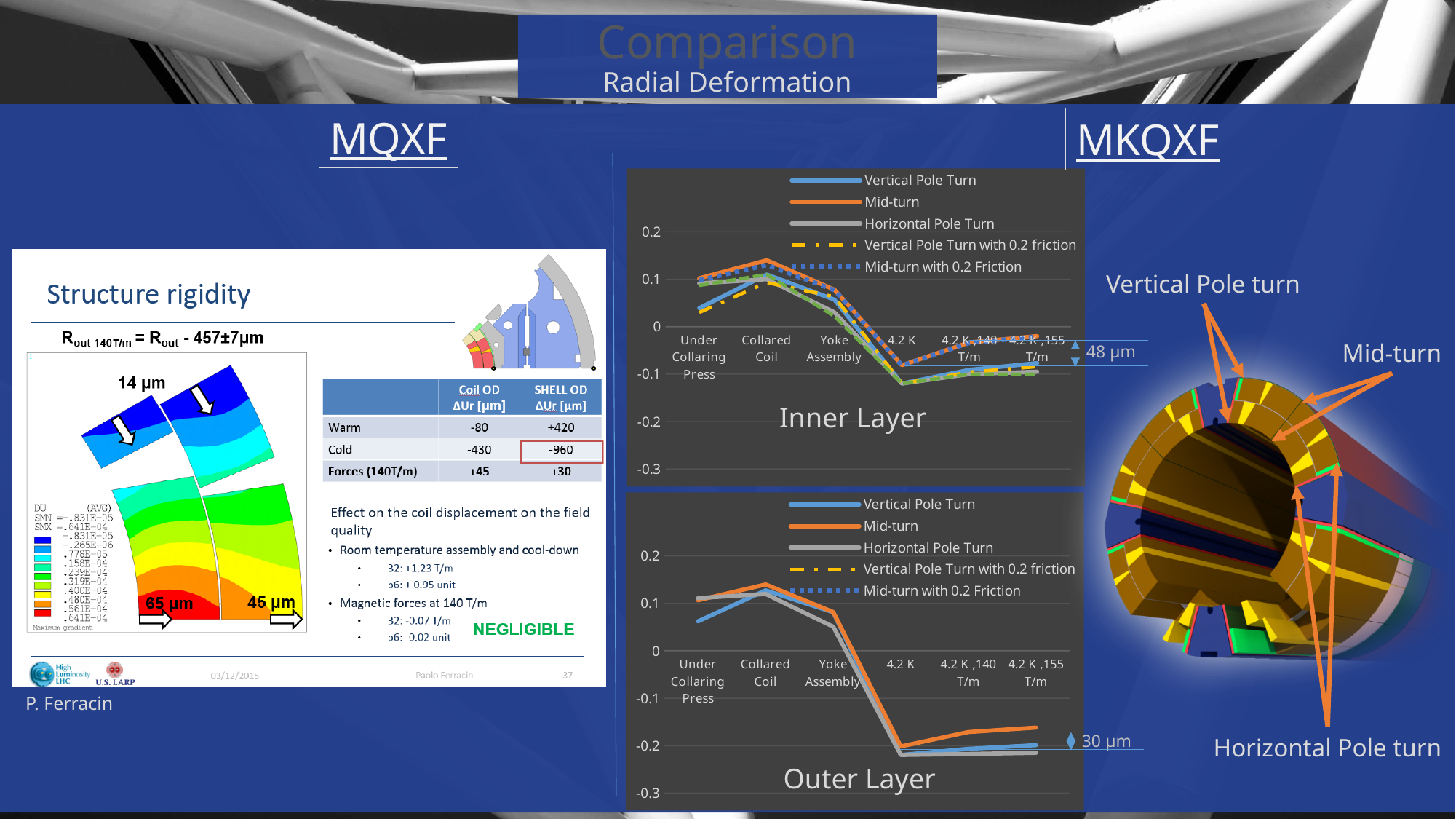
In the Outer Layer chart, is the Horizontal Pole Turn value at 4.2 K greater or less than -0.2? less How many categories are shown on the x axis of the Inner Layer chart? 6 What difference annotation is shown next to the right end of the Inner Layer chart? 48 µm What type of chart is the Inner Layer chart? line chart In the Outer Layer chart, at Under Collaring Press, which is larger: Vertical Pole Turn or Mid-turn? Mid-turn In the Outer Layer chart, is the Mid-turn value at 4.2 K ,155 T/m greater or less than -0.2? greater In the Inner Layer chart, is the Mid-turn value at Collared Coil greater or less than 0.1? greater In the Outer Layer chart, do the Mid-turn values rise or fall from Yoke Assembly to 4.2 K? fall In the Outer Layer chart, at which category does the Mid-turn series reach its lowest value? 4.2 K How many series does the legend of the Outer Layer chart list? 5 In the Inner Layer chart, at which category does the Mid-turn series reach its highest value? Collared Coil